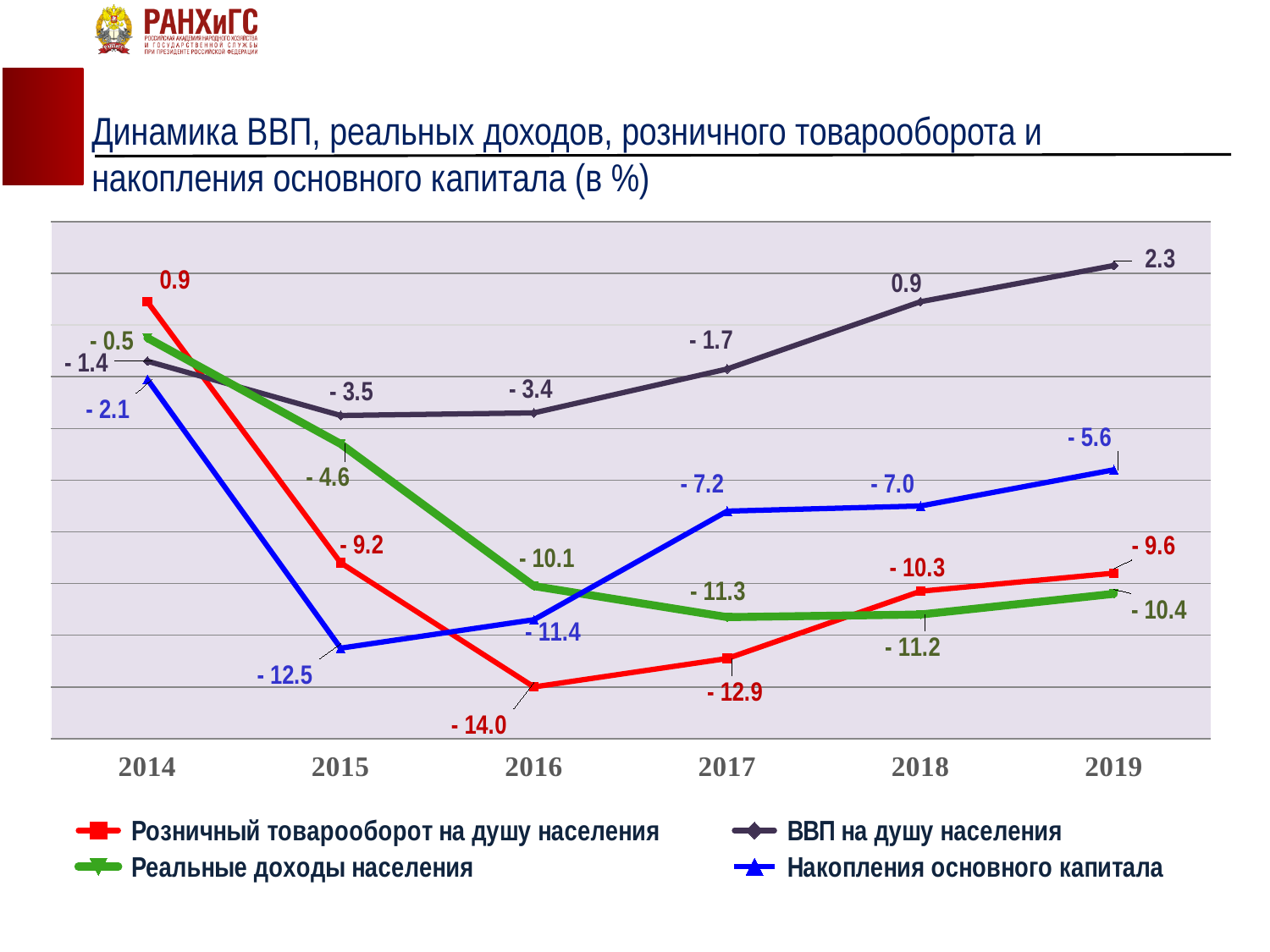
What is the difference between the 2019 and 2014 values for ВВП на душу населения? 3.7 In which year is ВВП на душу населения at its highest? 2019 How many series does the legend list? 4 In which year is Розничный товарооборот на душу населения at its lowest? 2016 What kind of chart is shown on the slide? Line chart What is the value for Накопления основного капитала in 2015? -12.5 How many years are shown on the x axis? 6 What is the value for ВВП на душу населения in 2019? 2.3 What is the value for Реальные доходы населения in 2017? -11.3 What is the value for Розничный товарооборот на душу населения in 2016? -14.0 Does the value for ВВП на душу населения rise or fall from 2016 to 2019? Rise Which is larger in 2018: the value for Накопления основного капитала or the value for Реальные доходы населения? Накопления основного капитала